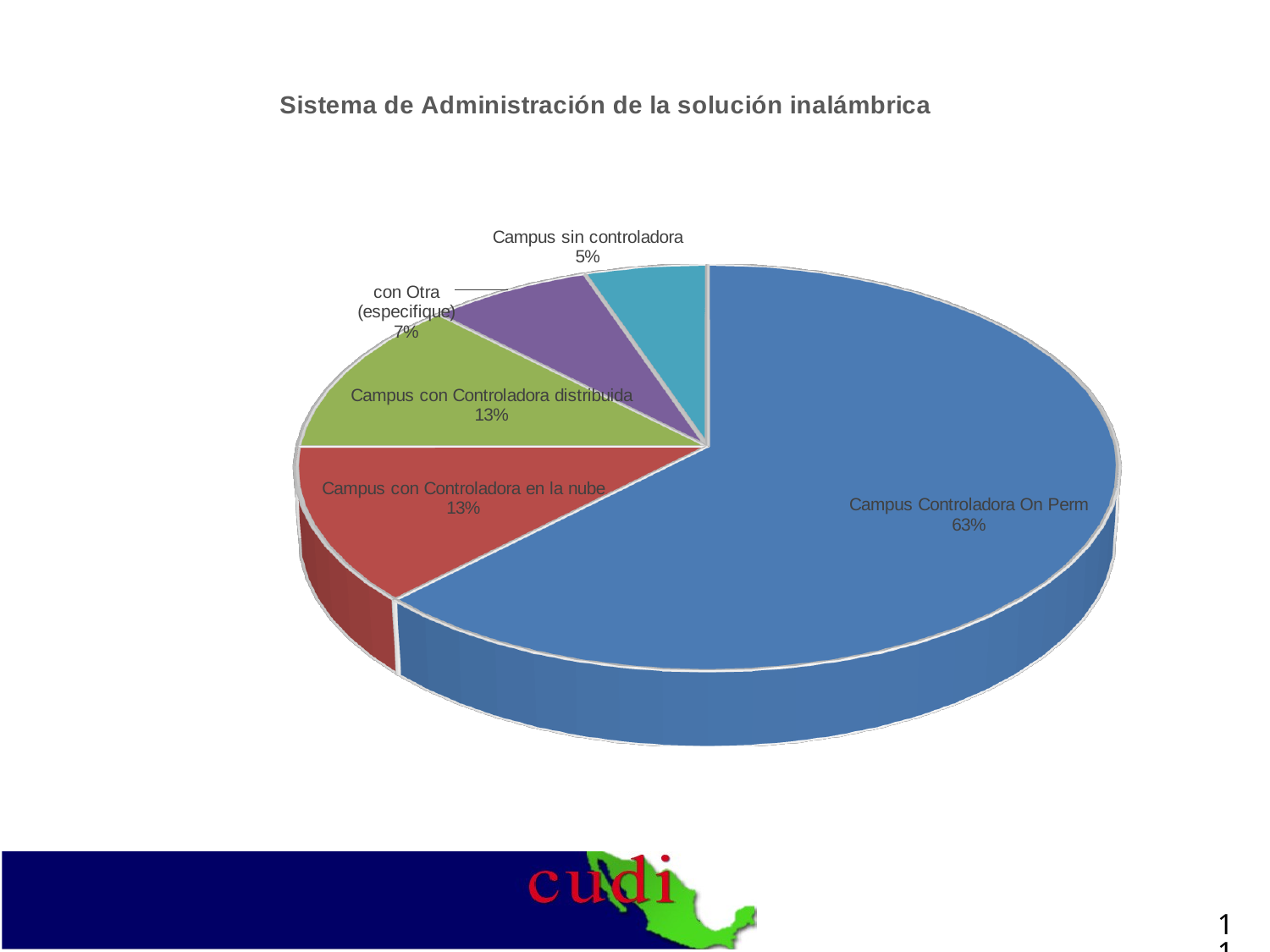
How many slices does the pie chart have? 5 Which is larger, the share for con Otra (especifique) or the share for Campus sin controladora? con Otra (especifique) What is the difference in percentage points between Campus Controladora On Perm and Campus con Controladora distribuida? 50 What share of the pie is con Otra (especifique)? 7% What share of the pie is Campus sin controladora? 5% What share of the pie is Campus con Controladora en la nube? 13% What colour is the Campus Controladora On Perm slice? Blue Which category has the largest slice of the pie? Campus Controladora On Perm What kind of chart is shown on the slide? Pie chart What is the title of the chart? Sistema de Administración de la solución inalámbrica Which category has the smallest slice of the pie? Campus sin controladora